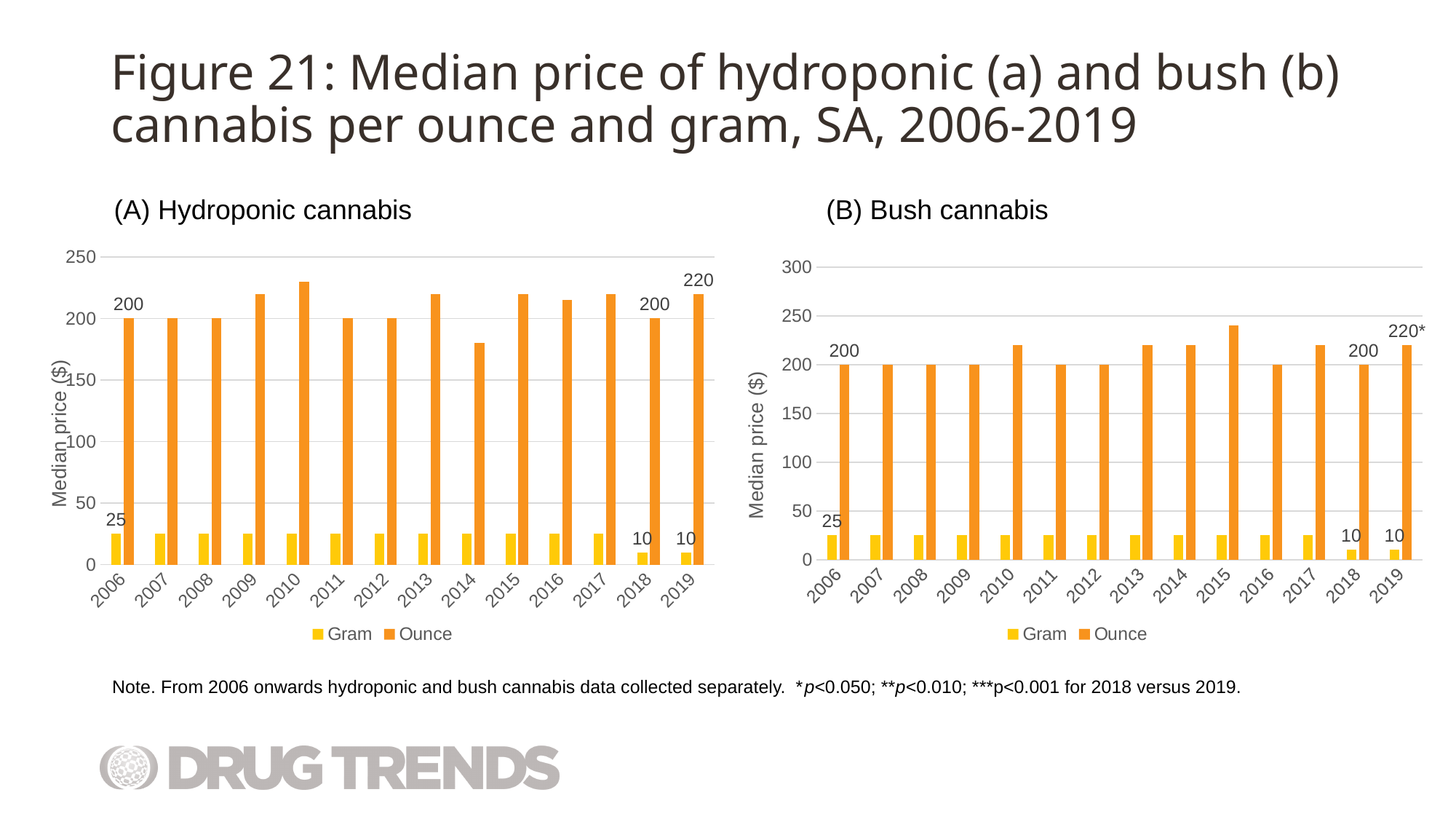
In the (A) Hydroponic cannabis chart, is the median price per ounce in 2014 greater or less than 200? less How many series does the legend of the (A) Hydroponic cannabis chart list? 2 How many years are shown on the x axis of the (B) Bush cannabis chart? 14 In the (A) Hydroponic cannabis chart, what is the median price per gram in 2006? 25 In the (A) Hydroponic cannabis chart, which year has the highest median price per ounce? 2010 In the (B) Bush cannabis chart, which year has the highest median price per ounce? 2015 In the (A) Hydroponic cannabis chart, what is the difference between the median price per ounce in 2019 and in 2018? 20 In the (A) Hydroponic cannabis chart, which year has the lowest median price per ounce? 2014 In the (B) Bush cannabis chart, is the median price per ounce in 2015 greater or less than 200? greater In the (A) Hydroponic cannabis chart, what is the median price per ounce in 2019? 220 In the (B) Bush cannabis chart, what is the median price per gram in 2018? 10 In the (B) Bush cannabis chart, what is the median price per ounce in 2019? 220*